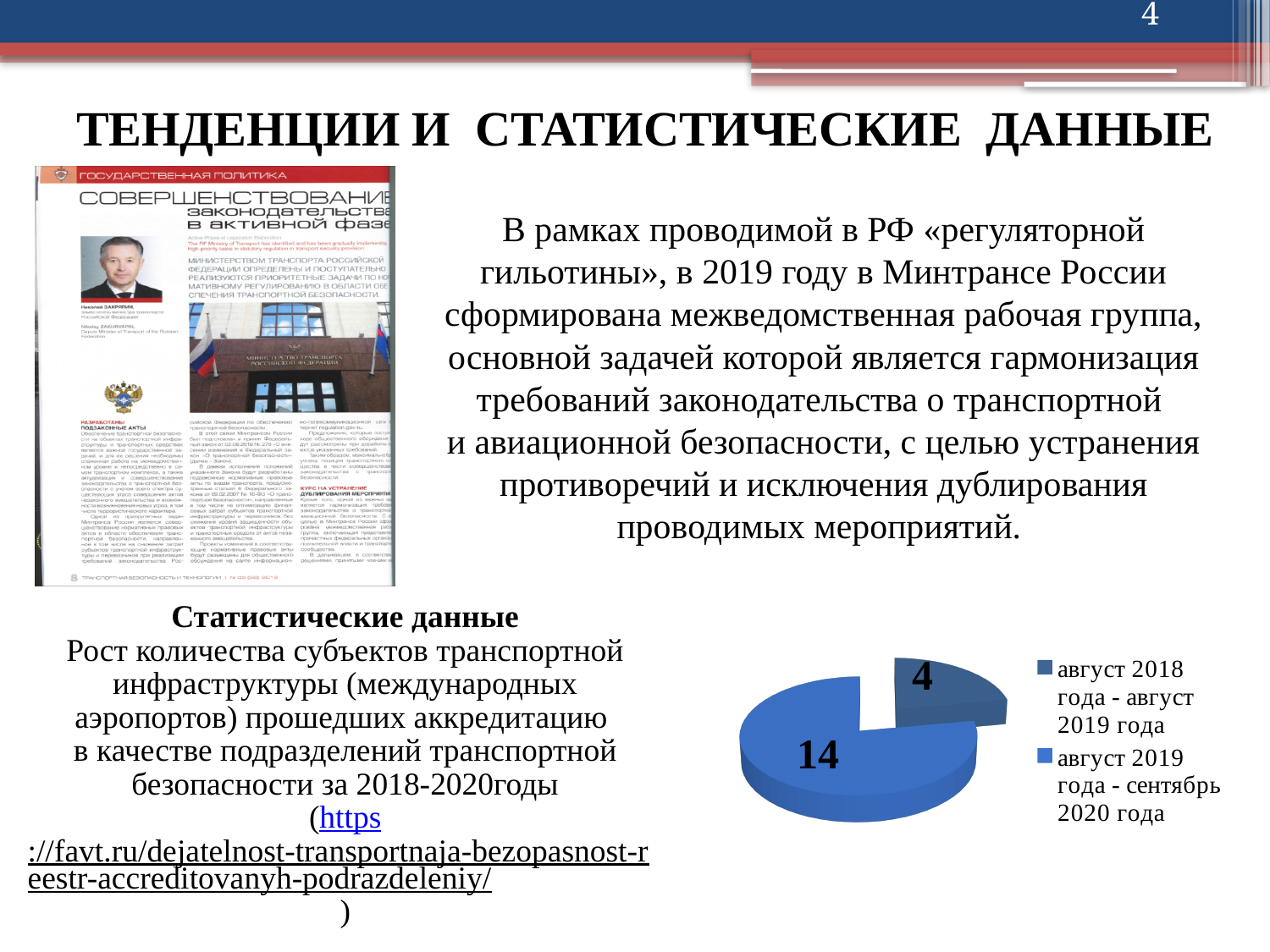
What is the difference between the values for 'август 2019 года - сентябрь 2020 года' and 'август 2018 года - август 2019 года'? 10 Which is larger: the value for 'август 2018 года - август 2019 года' or for 'август 2019 года - сентябрь 2020 года'? август 2019 года - сентябрь 2020 года What value is shown for the slice 'август 2018 года - август 2019 года'? 4 What value is shown for the slice 'август 2019 года - сентябрь 2020 года'? 14 What is the total of the two values shown in the pie chart? 18 How many slices does the pie chart have? 2 Is the value for 'август 2019 года - сентябрь 2020 года' greater or less than 10? greater Which period has the smallest slice in the pie chart? август 2018 года - август 2019 года Which period has the largest slice in the pie chart? август 2019 года - сентябрь 2020 года What is the first legend entry of the pie chart? август 2018 года - август 2019 года How many entries does the legend of the pie chart list? 2 What kind of chart is shown on the slide? pie chart